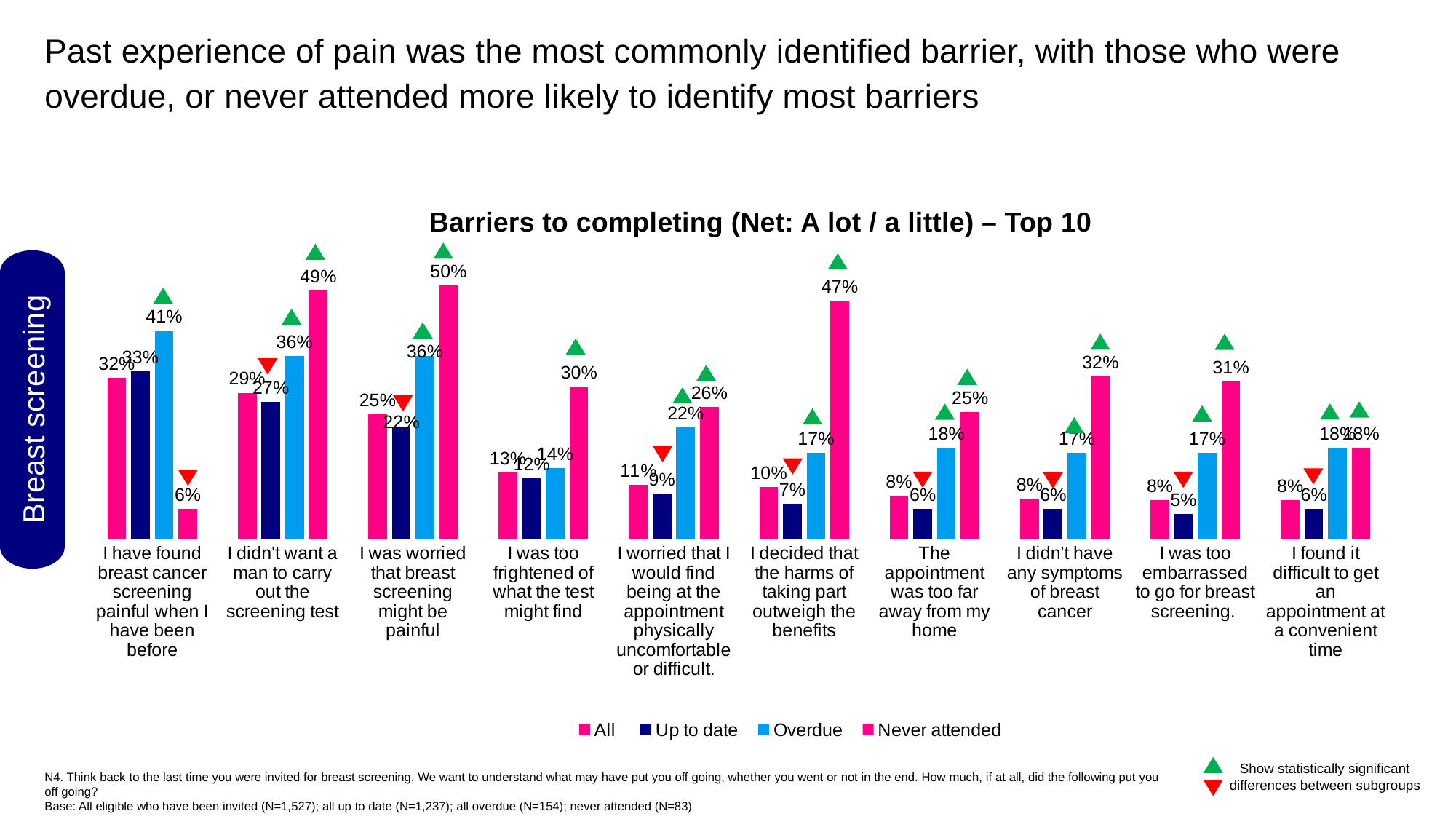
What is the title of the chart? Barriers to completing (Net: A lot / a little) – Top 10 Which category has the highest value for the All series? I have found breast cancer screening painful when I have been before What is the value for Overdue for 'I have found breast cancer screening painful when I have been before'? 41% What is the value for Up to date for 'I was too embarrassed to go for breast screening.'? 5% For 'I didn't want a man to carry out the screening test', which is larger: the Overdue value or the Never attended value? Never attended How many series does the legend list? 4 What is the difference between the Overdue and All values for 'The appointment was too far away from my home'? 10% What is the difference between the Never attended and Up to date values for 'I decided that the harms of taking part outweigh the benefits'? 40% What kind of chart is shown on the slide? bar chart Which category has the lowest value for the Never attended series? I have found breast cancer screening painful when I have been before How many barrier categories are shown on the x axis? 10 What is the value for Never attended for 'I was worried that breast screening might be painful'? 50%